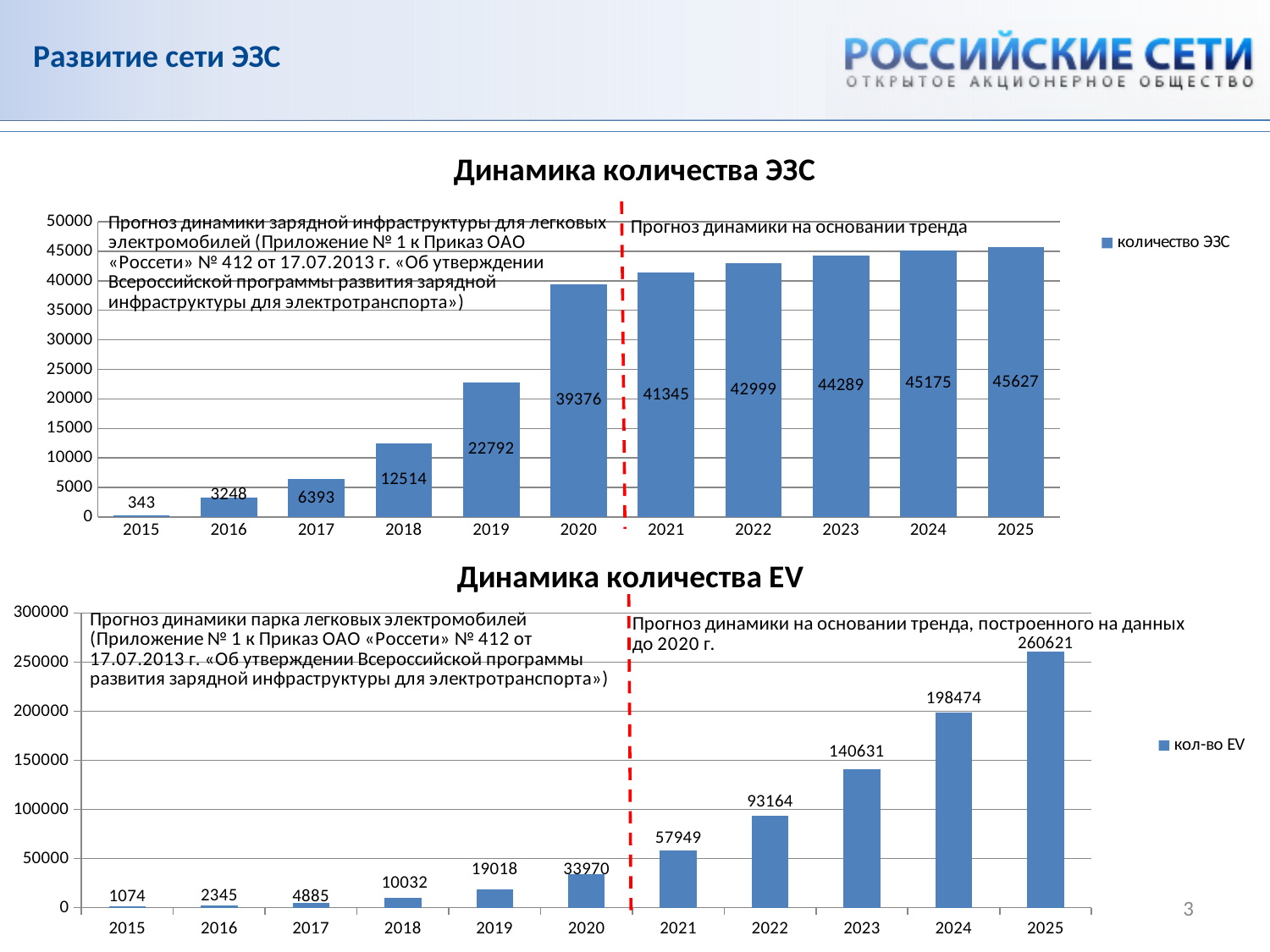
In the chart 'Динамика количества ЭЗС', how many years are shown on the x axis? 11 In the chart 'Динамика количества ЭЗС', what is the difference between the values for 2020 and 2019? 16584 In the chart 'Динамика количества EV', which year has the lowest value? 2015 What kind of chart is 'Динамика количества EV'? Bar chart In the chart 'Динамика количества EV', what is the value for 2023? 140631 In the chart 'Динамика количества ЭЗС', which year has the highest value? 2025 In the chart 'Динамика количества EV', do the values rise or fall from 2015 to 2025? Rise In the chart 'Динамика количества ЭЗС', what is the value for 2015? 343 What is the legend entry of the chart 'Динамика количества EV'? кол-во EV In the chart 'Динамика количества EV', what is the difference between the values for 2025 and 2024? 62147 In the chart 'Динамика количества EV', is the value for 2022 larger than the value for 2021? Yes, 2022 In the chart 'Динамика количества ЭЗС', what is the value for 2020? 39376